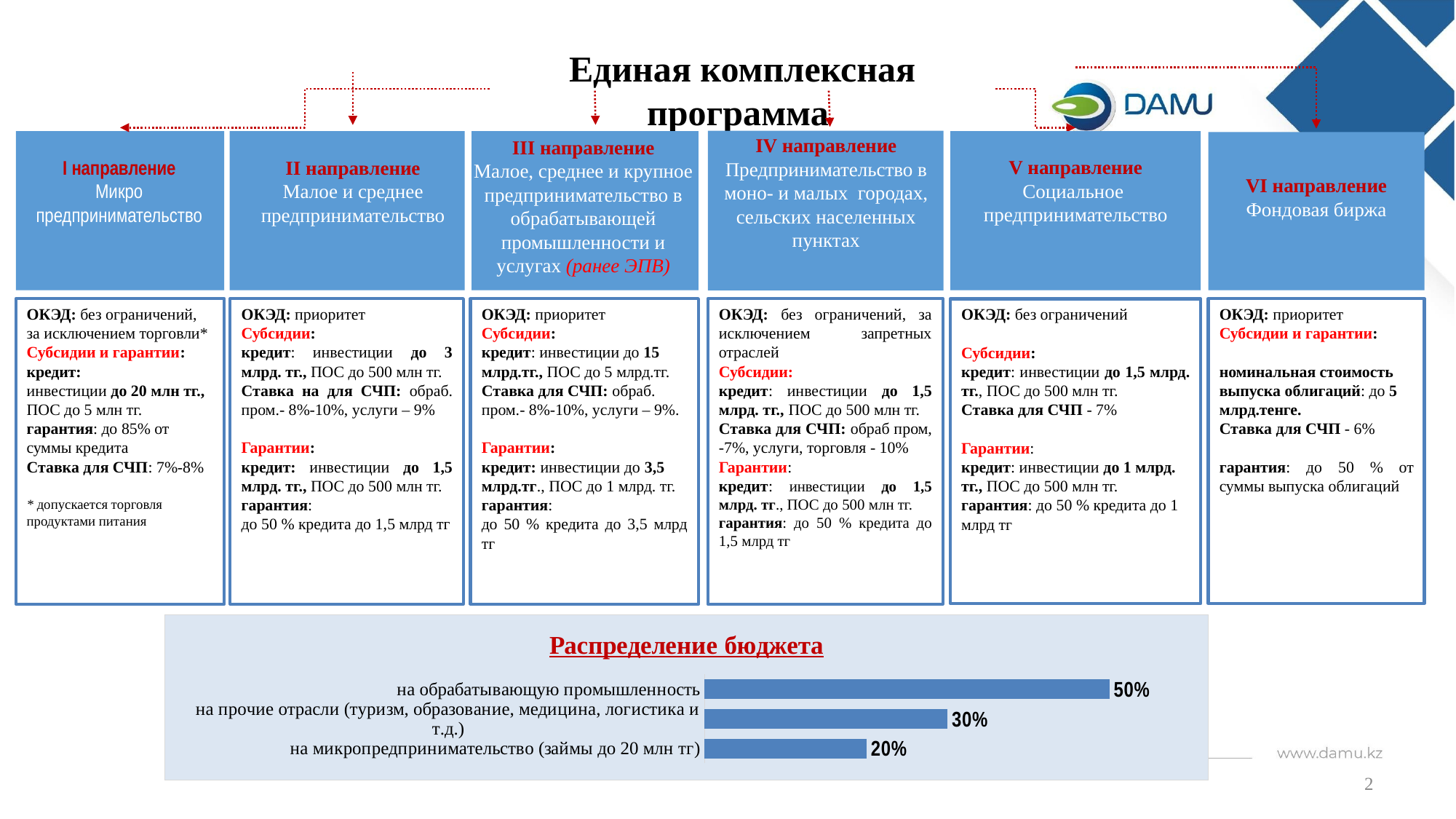
Which category has the lowest value in the 'Распределение бюджета' chart? на микропредпринимательство (займы до 20 млн тг) How many categories are shown in the 'Распределение бюджета' chart? 3 What is the title of the chart at the bottom of the slide? Распределение бюджета What is the value for 'на микропредпринимательство (займы до 20 млн тг)' in the 'Распределение бюджета' chart? 20% What is the value for 'на обрабатывающую промышленность' in the 'Распределение бюджета' chart? 50% What is the total of the three values shown in the 'Распределение бюджета' chart? 100% What is the difference between the values for 'на обрабатывающую промышленность' and 'на микропредпринимательство (займы до 20 млн тг)' in the 'Распределение бюджета' chart? 30% What is the value for 'на прочие отрасли (туризм, образование, медицина, логистика и т.д.)' in the 'Распределение бюджета' chart? 30% Which category has the highest value in the 'Распределение бюджета' chart? на обрабатывающую промышленность What is the difference between the values for 'на прочие отрасли' and 'на микропредпринимательство' in the 'Распределение бюджета' chart? 10% What kind of chart is the 'Распределение бюджета' chart? bar chart In the 'Распределение бюджета' chart, which is larger: 'на обрабатывающую промышленность' or 'на прочие отрасли'? на обрабатывающую промышленность